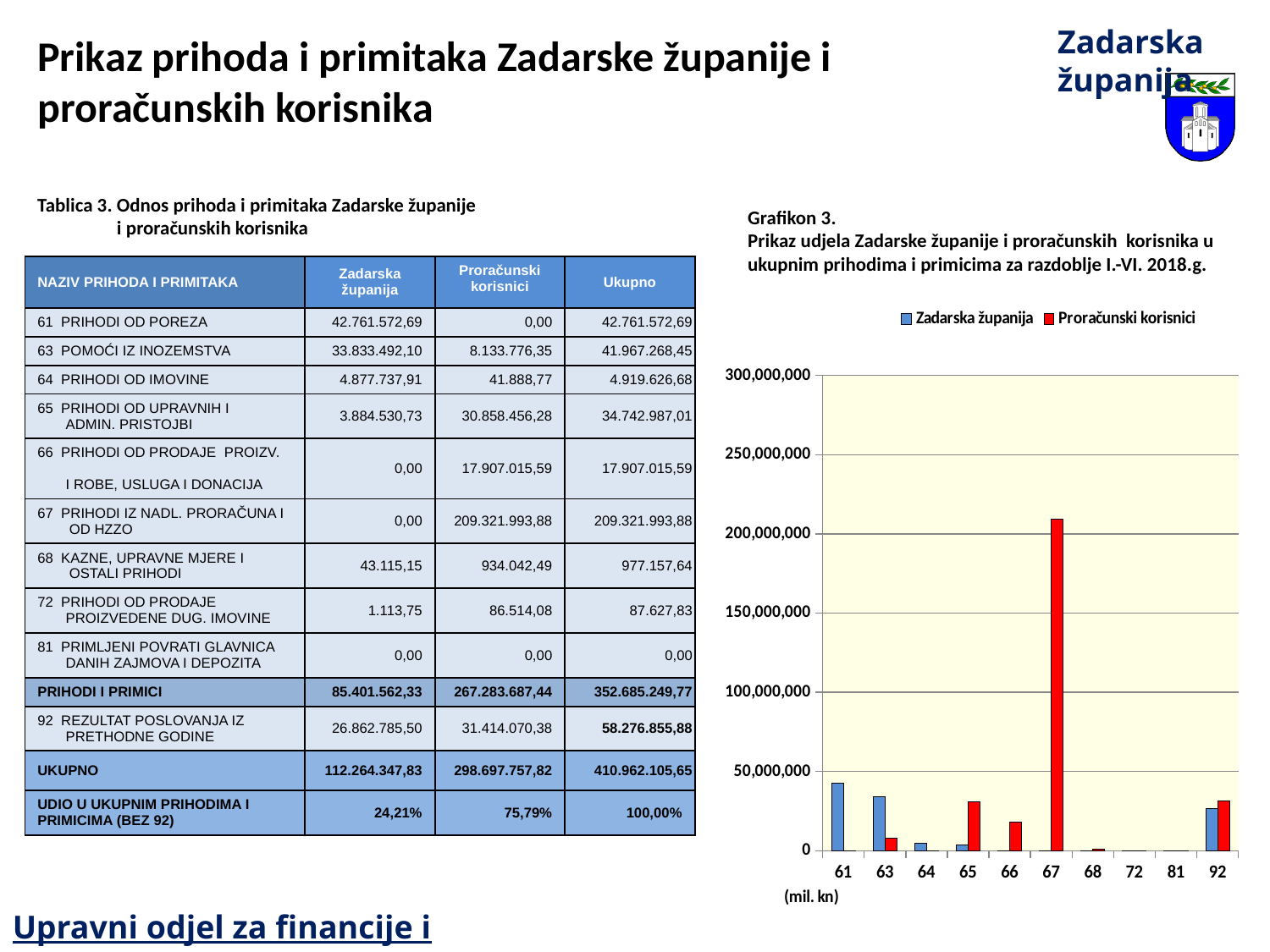
In the chart, which is larger for Zadarska županija: category 61 or category 63? 61 Is the value for Proračunski korisnici in category 67 greater or less than 200,000,000? greater Which colour represents Proračunski korisnici in the chart? red In category 65, which series has the larger value: Zadarska županija or Proračunski korisnici? Proračunski korisnici What kind of chart is Grafikon 3 on the slide? bar chart Which series is shown in blue in the chart? Zadarska županija Is the value for Proračunski korisnici in category 65 greater or less than 50,000,000? less How many series does the legend of the chart list? 2 In the chart, which category has the highest value for Zadarska županija? 61 How many categories are shown on the x axis of the chart? 10 Is the value for Zadarska županija in category 61 greater or less than 50,000,000? less In the chart, which category has the highest value for Proračunski korisnici? 67